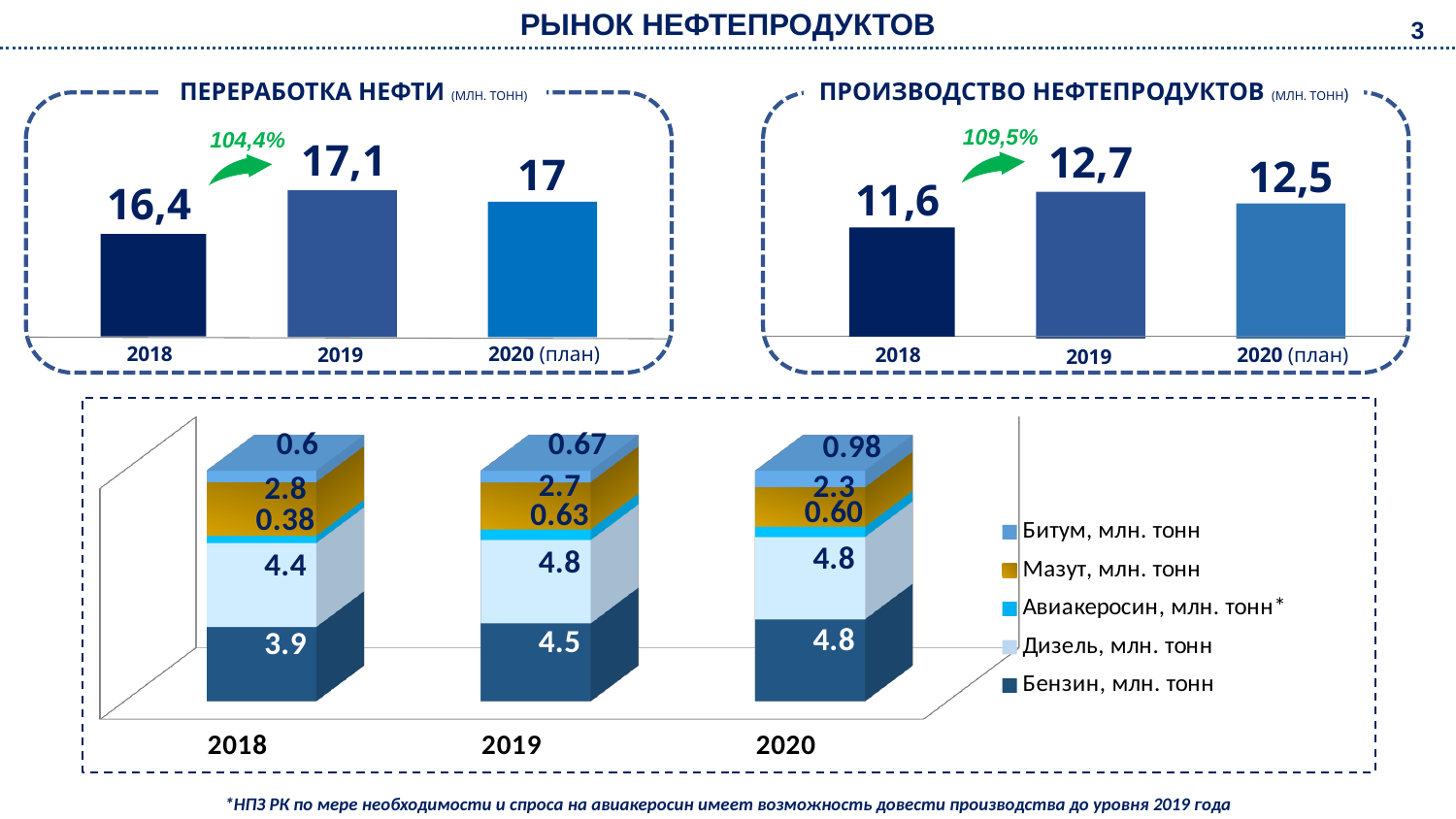
In the 'ПРОИЗВОДСТВО НЕФТЕПРОДУКТОВ' chart, what is the value for 2019? 12,7 In the 'ПРОИЗВОДСТВО НЕФТЕПРОДУКТОВ' chart, what growth percentage is shown between 2018 and 2019? 109,5% In the 'ПЕРЕРАБОТКА НЕФТИ' chart, what is the difference between the 2019 and 2018 values? 0,7 In the 'ПРОИЗВОДСТВО НЕФТЕПРОДУКТОВ' chart, which year has the lowest value? 2018 How many series does the legend of the bottom stacked bar chart list? 5 In the bottom stacked bar chart, which is larger in 2018: Дизель or Бензин? Дизель In the 'ПЕРЕРАБОТКА НЕФТИ' chart, which year has the highest value? 2019 What kind of chart is the 'ПЕРЕРАБОТКА НЕФТИ' chart? bar chart In the 'ПЕРЕРАБОТКА НЕФТИ' chart, what is the value for 2018? 16,4 How many years are shown on the x axis of the bottom stacked bar chart? 3 In the bottom stacked bar chart, what is the value for Мазут in 2018? 2.8 In the bottom stacked bar chart, what is the value for Бензин in 2020? 4.8